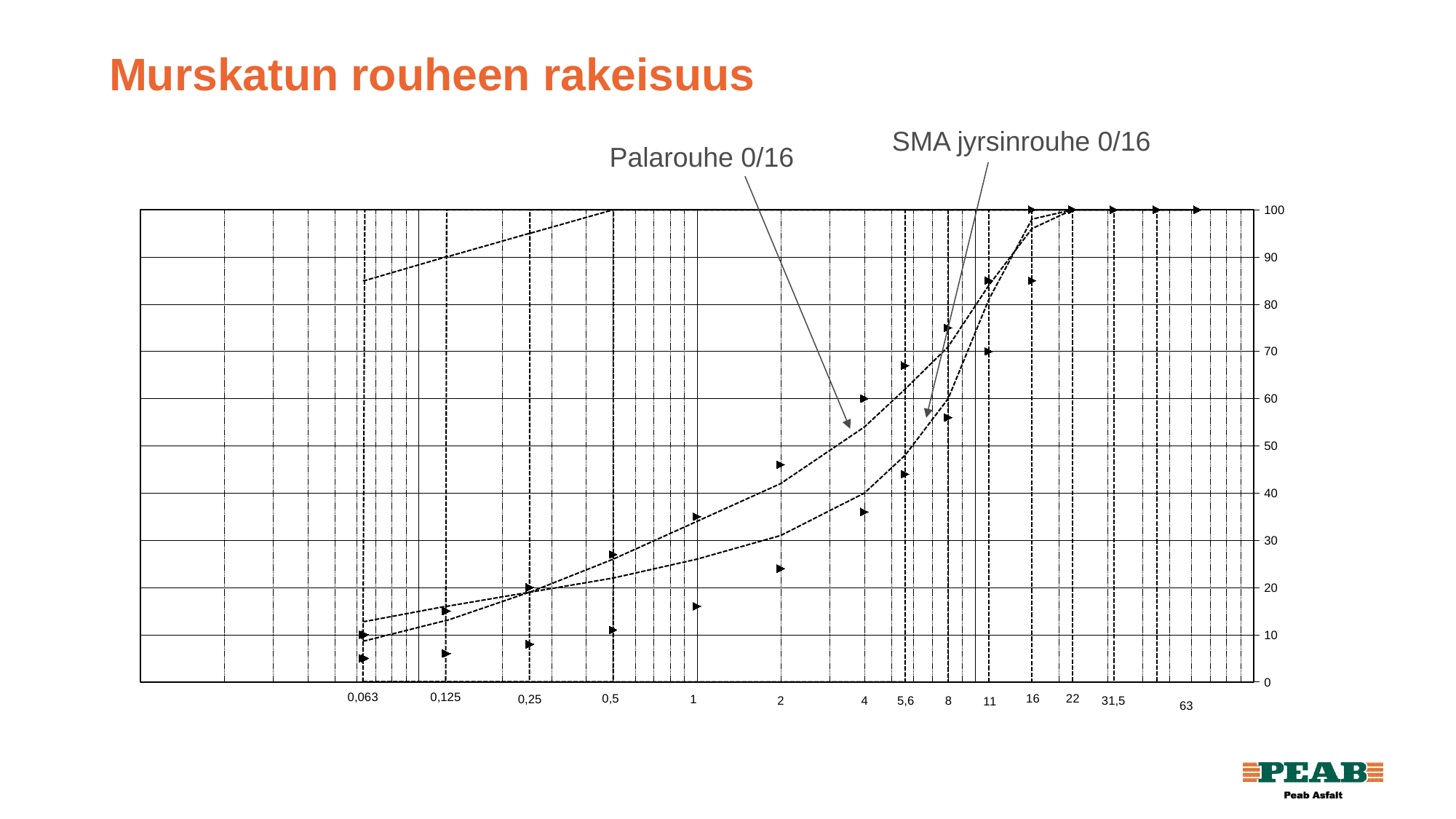
How many labelled tick values are shown on the x axis? 14 Do the curves rise or fall as the x axis values increase? rise At x = 4, which curve is higher, Palarouhe 0/16 or SMA jyrsinrouhe 0/16? Palarouhe 0/16 How many labelled curves are shown on the chart? 2 Is the value of the Palarouhe 0/16 curve at 1 greater or less than 30? greater What kind of chart is shown on the slide? line chart Is the value of the SMA jyrsinrouhe 0/16 curve at 4 greater or less than 50? less What is the highest value labelled on the y axis? 100 Is the value of the SMA jyrsinrouhe 0/16 curve at 1 greater or less than 30? less What is the title of the slide? Murskatun rouheen rakeisuus